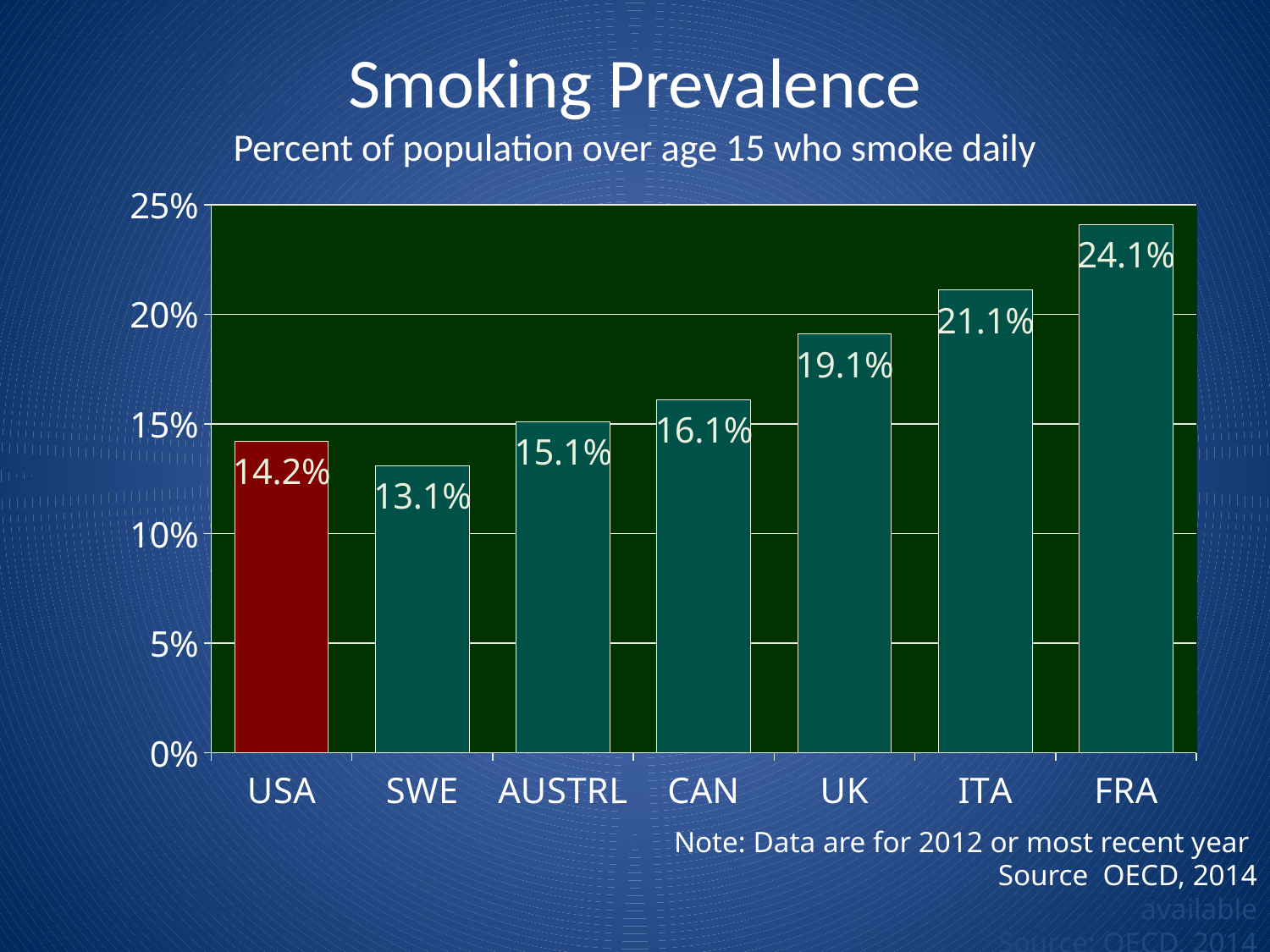
What is the difference between the values for FRA and the USA? 9.9% What is the smoking prevalence value shown for the USA? 14.2% What is the value shown for FRA? 24.1% Is the value for UK greater or less than 20%? less Which country has the lowest smoking prevalence on the chart? SWE How many countries are shown on the chart? 7 Which bar is coloured differently (red) from the others? USA Which country has the highest smoking prevalence on the chart? FRA What kind of chart is shown on the slide? bar chart Which has a higher value, AUSTRL or SWE? AUSTRL What is the value shown for CAN? 16.1% What is the difference between the values for ITA and UK? 2.0%